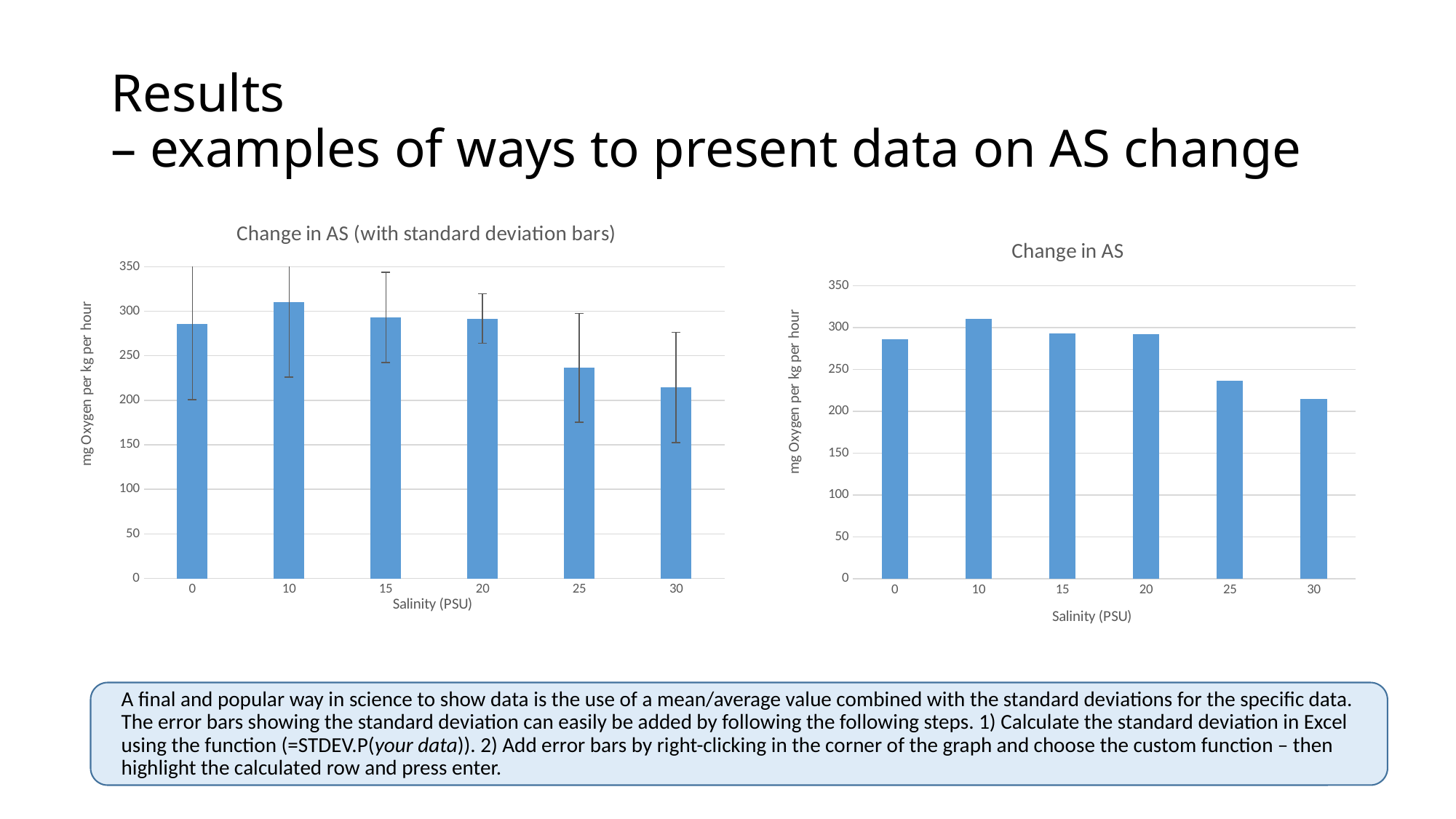
In the chart titled "Change in AS (with standard deviation bars)", is the value for salinity 30 greater or less than 250? less In the chart titled "Change in AS" on the right, which salinity (PSU) has the highest value? 10 In the chart titled "Change in AS" on the right, how many salinity categories are plotted? 6 In the chart titled "Change in AS (with standard deviation bars)", what kind of chart is shown? bar chart In the chart titled "Change in AS" on the right, is the value for salinity 25 greater or less than 200? greater In the chart titled "Change in AS" on the right, which is larger: the value for salinity 10 or salinity 30? 10 What is the x-axis label of the chart titled "Change in AS (with standard deviation bars)"? Salinity (PSU) In the chart titled "Change in AS (with standard deviation bars)", is the value for salinity 10 greater or less than 300? greater In the chart titled "Change in AS (with standard deviation bars)", which is larger: the value for salinity 0 or salinity 25? 0 What is the y-axis label of the chart titled "Change in AS" on the right? mg Oxygen per kg per hour In the chart titled "Change in AS" on the right, which salinity (PSU) has the lowest value? 30